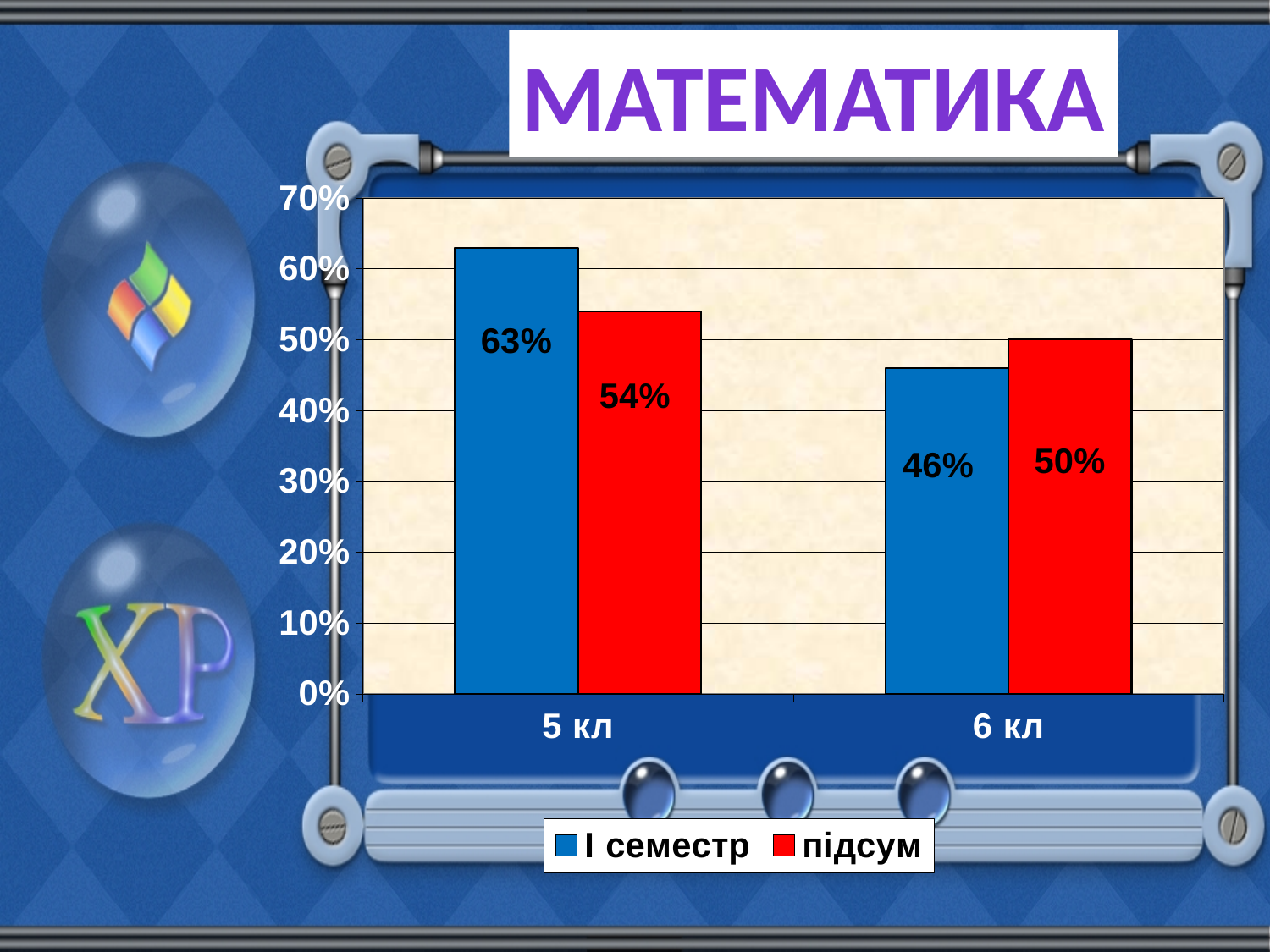
What is the value for "підсум" in the "5 кл" category? 54% Which category has the highest "І семестр" value? 5 кл How many series does the legend list? 2 Is the "І семестр" value for "5 кл" greater or less than 60%? greater Which category has the lowest "підсум" value? 6 кл What is the difference between the "І семестр" and "підсум" values for "5 кл"? 9% What is the title of the chart? МАТЕМАТИКА What is the value for "підсум" in the "6 кл" category? 50% What kind of chart is shown on the slide? bar chart How many categories are shown on the x axis? 2 Which is larger for "6 кл": the "І семестр" value or the "підсум" value? підсум What is the value for "І семестр" in the "5 кл" category? 63%